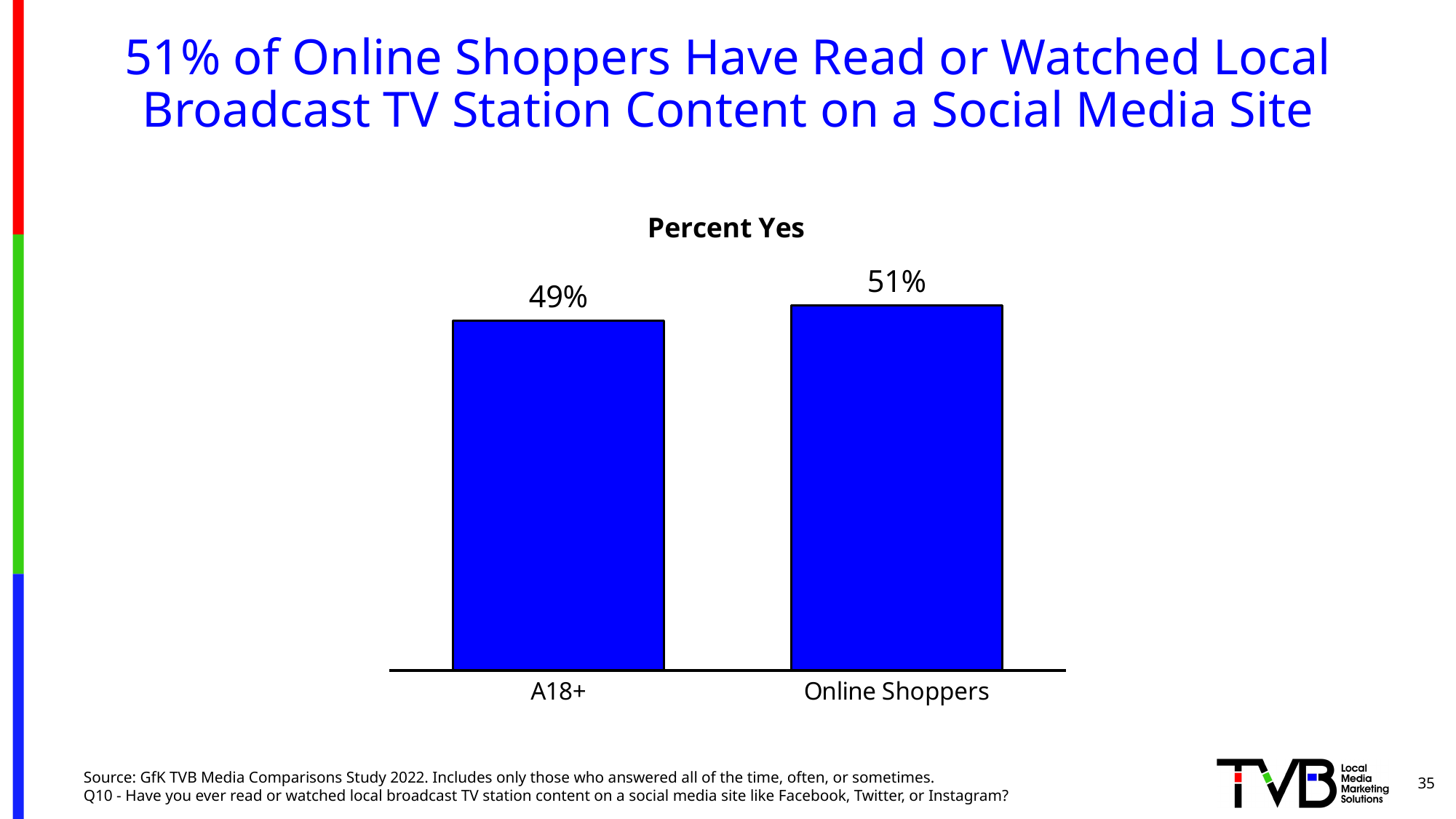
What is the difference between the values for Online Shoppers and A18+? 2% What is the value for A18+? 49% What kind of chart is shown on the slide? bar chart How many categories are shown in the chart? 2 What colour are the bars in the chart? blue What is the value for Online Shoppers? 51% Which is larger, the value for A18+ or the value for Online Shoppers? Online Shoppers What is the title of the chart? Percent Yes Which category has the highest value? Online Shoppers Which category has the lowest value? A18+